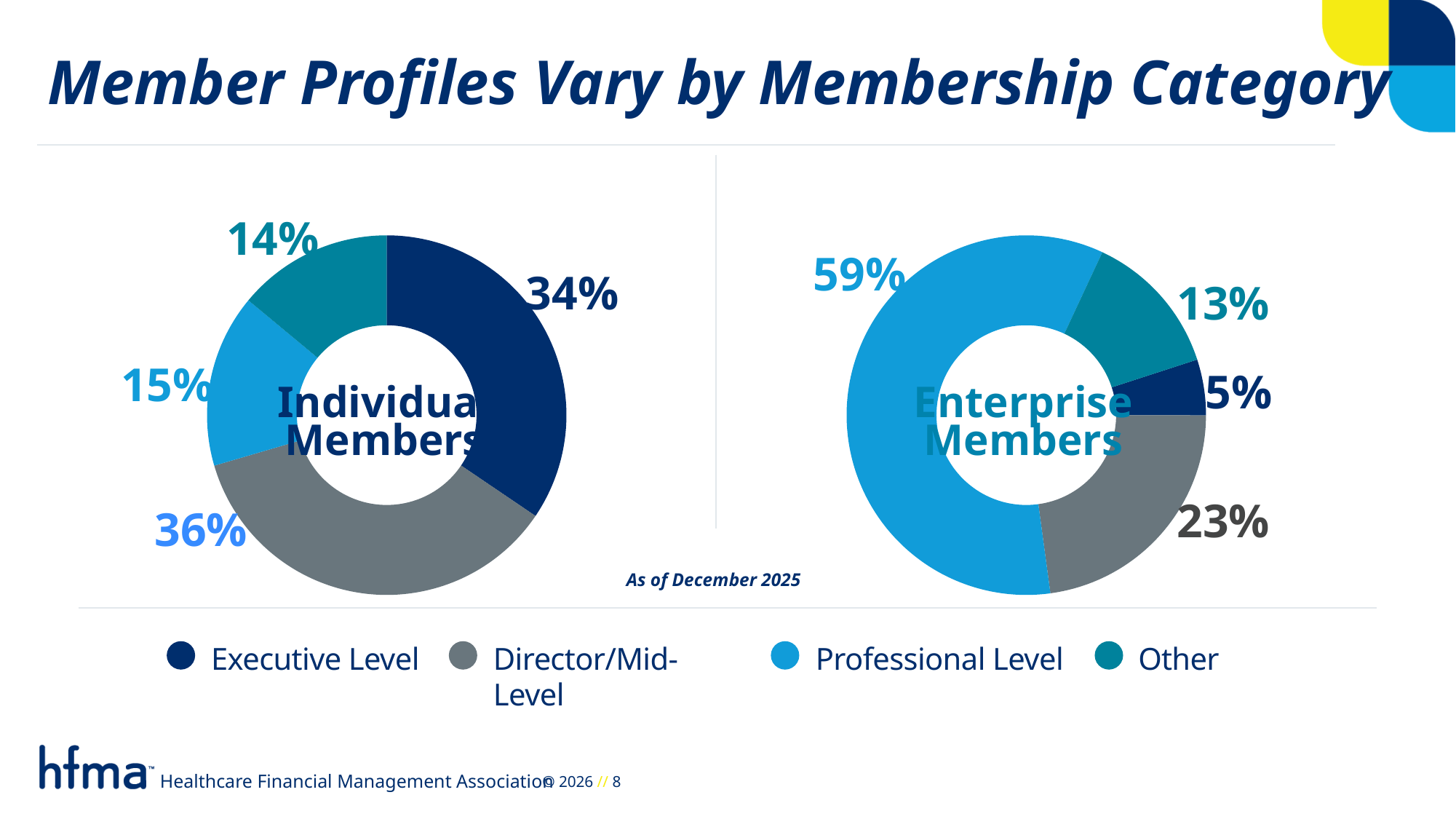
Which is larger: the Other share in the Individual Members chart or the Other share in the Enterprise Members chart? Individual Members In the Individual Members chart, what share is Executive Level? 34% In the Enterprise Members chart, which category has the largest share? Professional Level In the Individual Members chart, which category has the smallest share? Other In the Enterprise Members chart, what is the difference between the Professional Level share and the Director/Mid-Level share? 36% In the Individual Members chart, what share is Director/Mid-Level? 36% How many categories does the legend list? 4 In the Enterprise Members chart, what share is Professional Level? 59% In the Enterprise Members chart, what share is Executive Level? 5% What kind of chart is used for Individual Members? Donut (pie) chart In the Enterprise Members chart, which category has the smallest share? Executive Level In the Individual Members chart, what is the difference between the Director/Mid-Level share and the Professional Level share? 21%